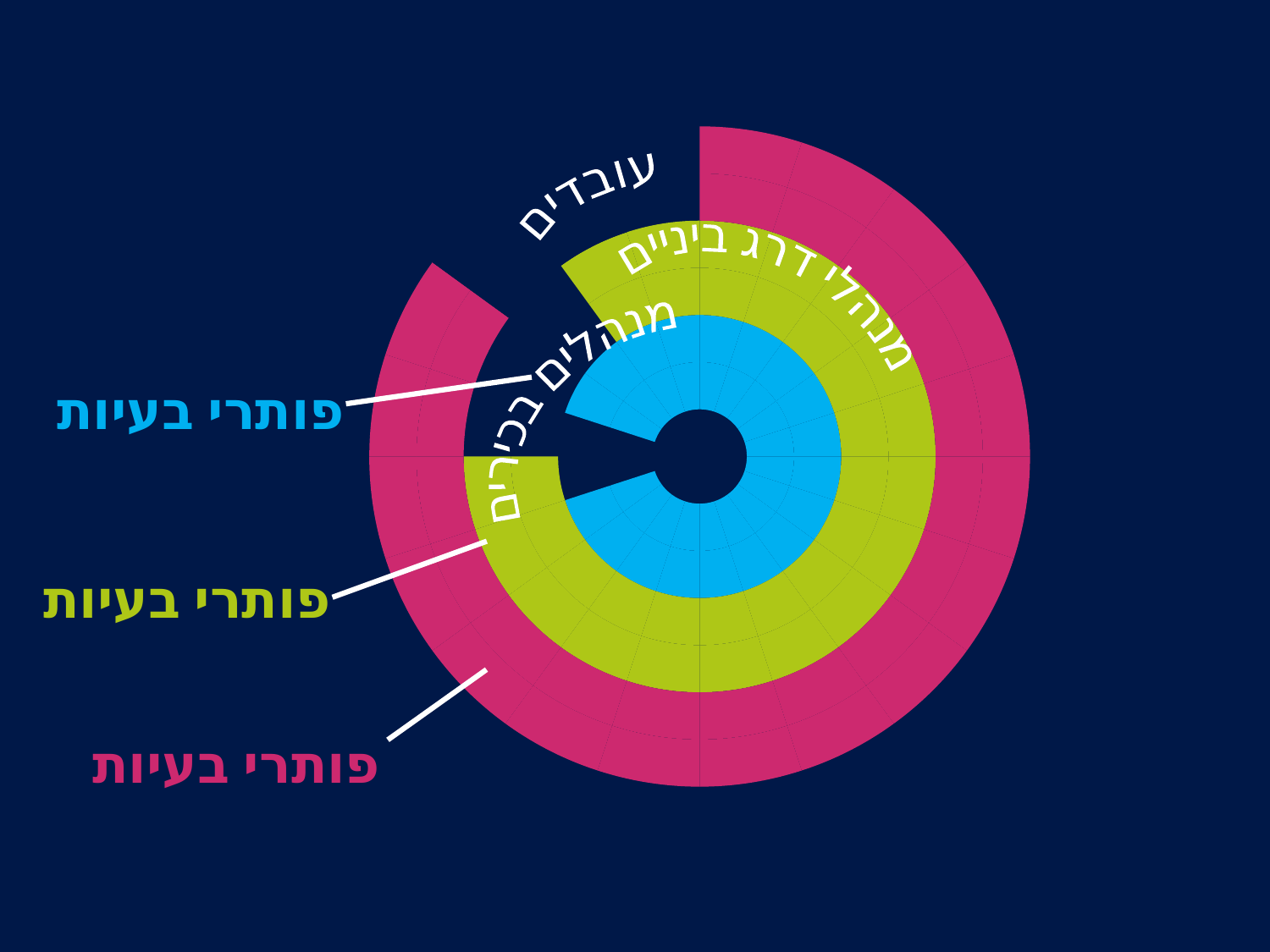
Which colour is the outermost ring of the chart? Pink What label is written along the inner blue ring? מנהלים בכירים Which colour is the innermost ring of the chart? Blue What label is written along the outer pink ring? עובדים Which ring does the label 'מנהלי דרג ביניים' belong to: the inner, middle or outer ring? Middle What text do the three callout labels on the left of the chart all say? פותרי בעיות What kind of chart is shown on the slide? Doughnut chart Are any numeric data values printed on the chart? No What label is written along the middle green ring? מנהלי דרג ביניים